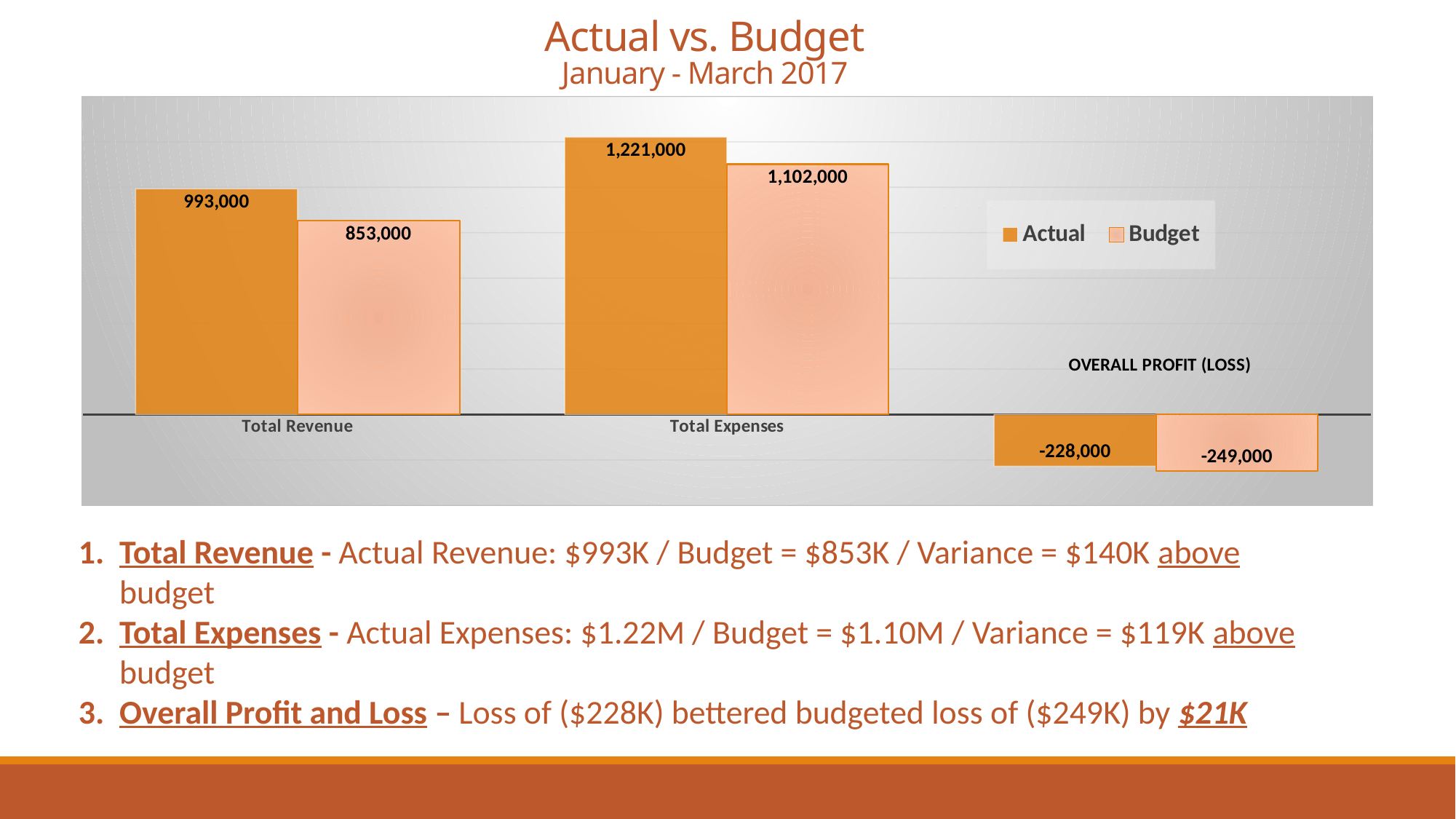
What is the Actual value for Total Expenses? 1,221,000 What kind of chart is shown on the slide? Bar chart What is the difference between the Actual and Budget values for Total Expenses? 119,000 What is the Budget value for Total Revenue? 853,000 What is the Actual value for Total Revenue? 993,000 What is the Budget value for Overall Profit (Loss)? -249,000 Which is larger for Total Expenses, the Actual value or the Budget value? Actual What is the Actual value for Overall Profit (Loss)? -228,000 What is the Budget value for Total Expenses? 1,102,000 Which category has the highest Actual value? Total Expenses How many series does the legend list? 2 What is the difference between the Actual and Budget values for Total Revenue? 140,000